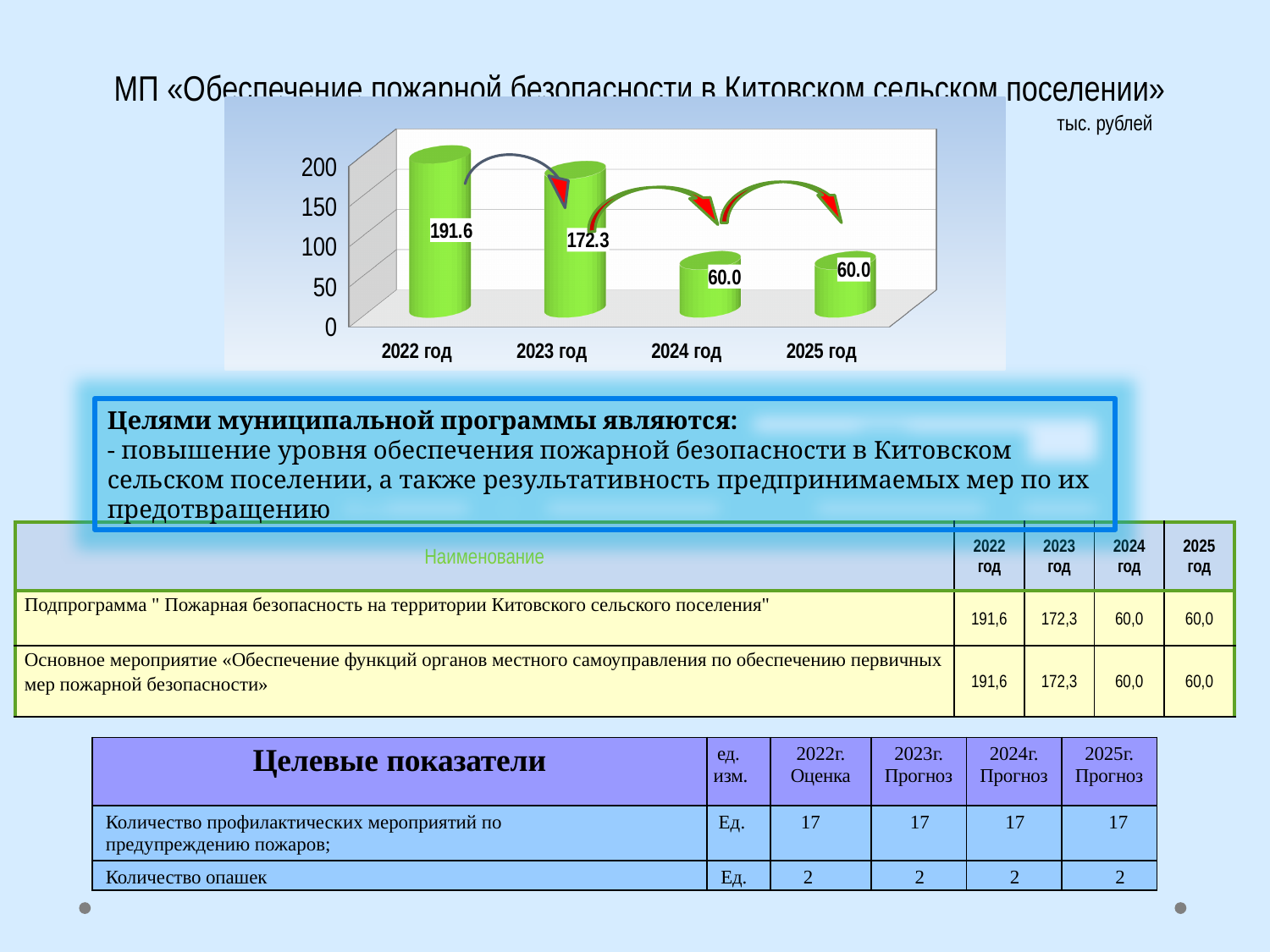
Is the value for 2024 год greater or less than 100? less What is the difference between the values for 2023 год and 2024 год? 112.3 Which year has the highest value in the chart? 2022 год Which is larger, the value for 2023 год or the value for 2025 год? 2023 год What is the value for 2022 год in the chart? 191.6 Is the value for 2022 год greater or less than 150? greater How many years are shown on the x axis of the chart? 4 Do the values in the chart rise or fall from 2022 год to 2024 год? fall What is the difference between the values for 2022 год and 2023 год? 19.3 What is the value for 2023 год in the chart? 172.3 What is the value for 2024 год in the chart? 60.0 What kind of chart is shown on the slide? bar chart